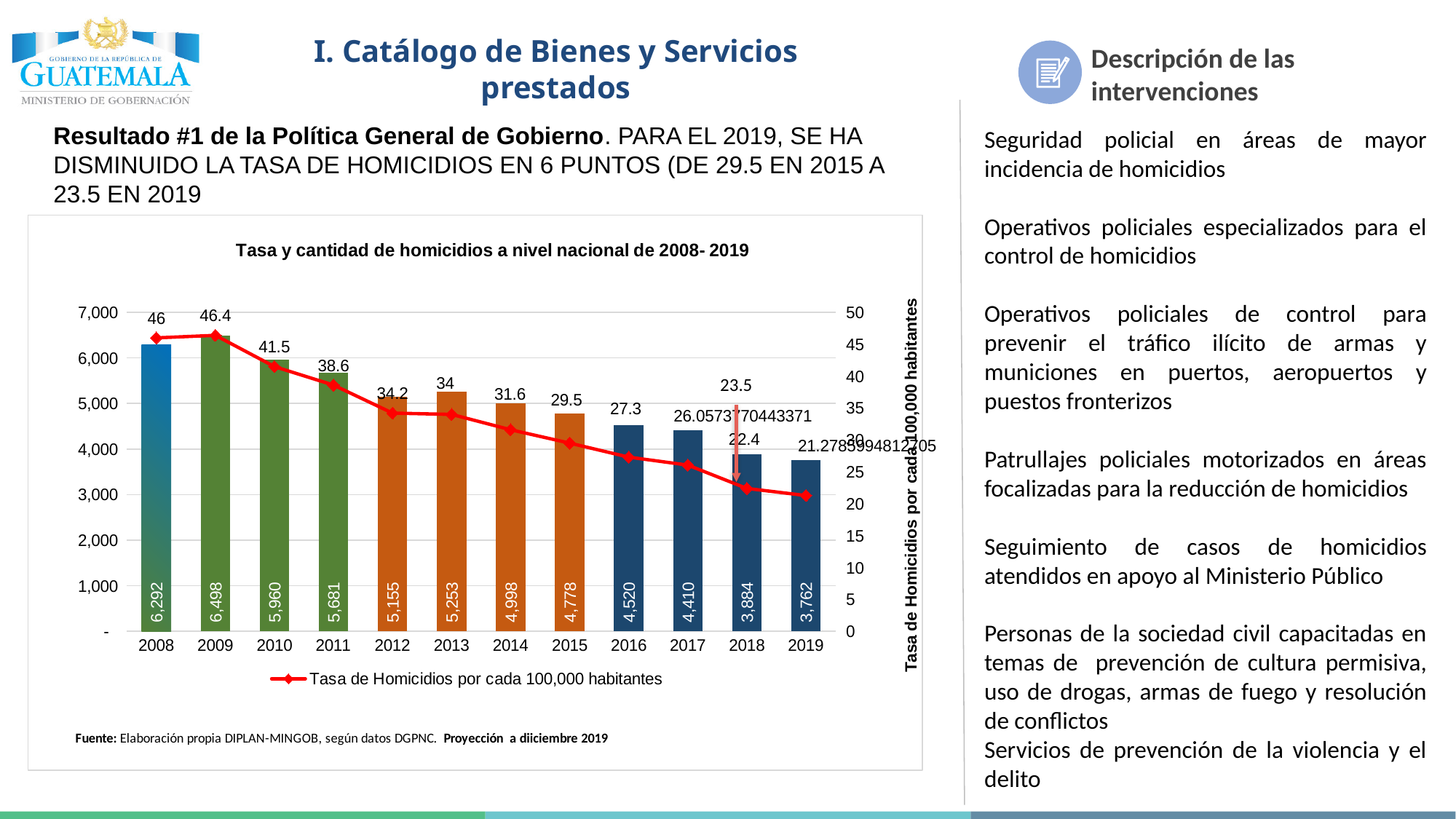
Which year has the highest number of homicides? 2009 How many series does the legend list? 1 How many homicides does the bar for 2008 show? 6,292 What is the title of the chart? Tasa y cantidad de homicidios a nivel nacional de 2008- 2019 What kind of chart is shown on the slide? Bar chart with a line Which year has the lowest number of homicides? 2019 What is the difference between the number of homicides in 2015 and in 2019? 1,016 Which year has more homicides, 2012 or 2013? 2013 What is the homicide rate per 100,000 inhabitants shown for 2015? 29.5 Does the homicide rate line rise or fall from 2009 to 2019? Fall What is the homicide rate per 100,000 inhabitants shown for 2018? 22.4 How many years are shown on the x axis of the chart? 12